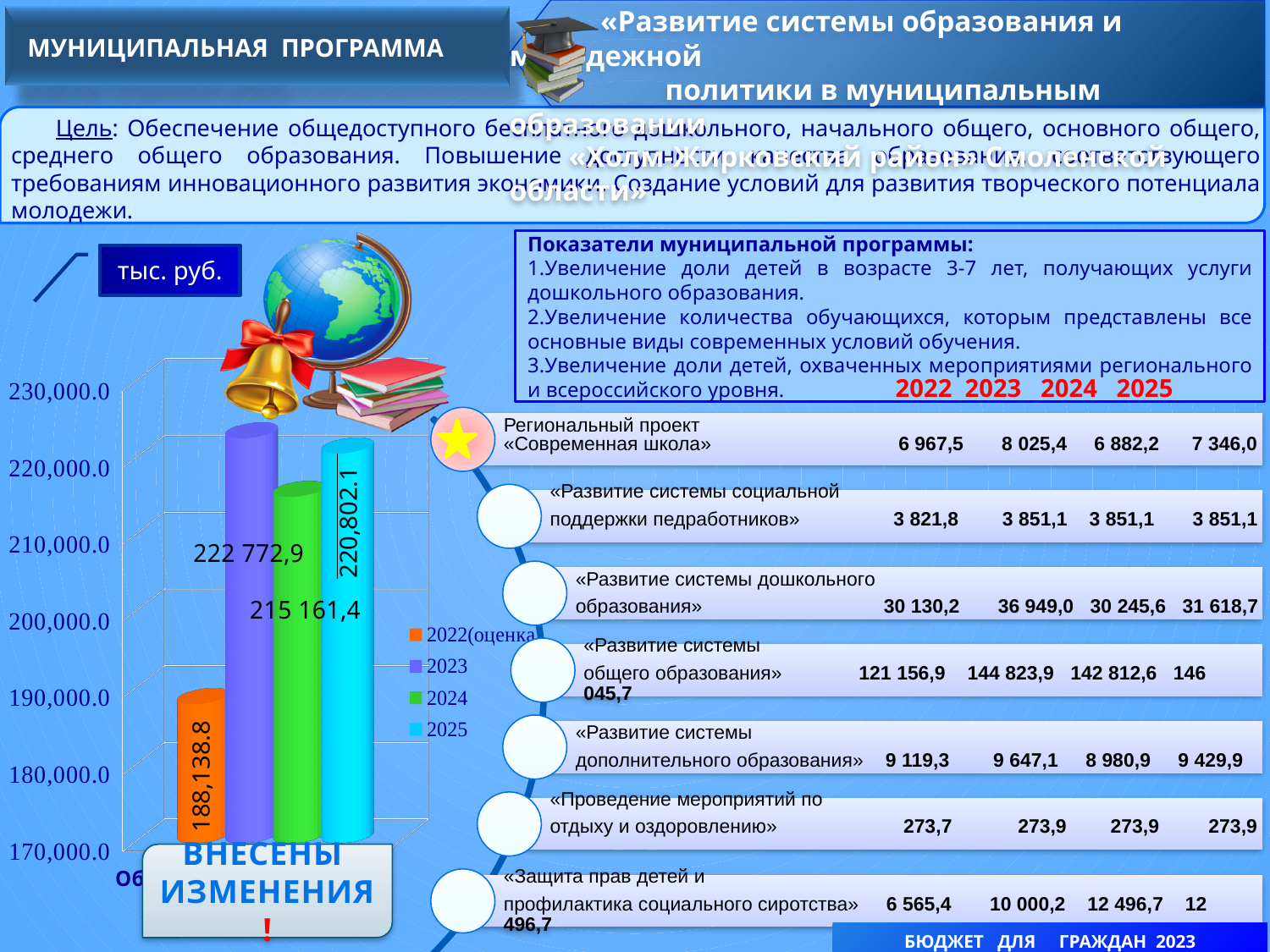
Which year has the highest bar in the chart? 2023 What is the value of the 2022(оценка) bar in the chart? 188,138.8 What is the value of the 2023 bar in the chart? 222 772,9 What is the value of the 2024 bar in the chart? 215 161,4 Is the value for 2022(оценка) greater or less than 190,000.0? less What is the value of the 2025 bar in the chart? 220,802.1 How many entries does the chart legend list? 4 What is the difference between the 2023 value and the 2024 value in the chart? 7 611,5 What type of chart is shown on the slide? bar chart How many bars are plotted in the chart? 4 Which is larger in the chart, the value for 2024 or the value for 2025? 2025 Which year has the lowest bar in the chart? 2022(оценка)